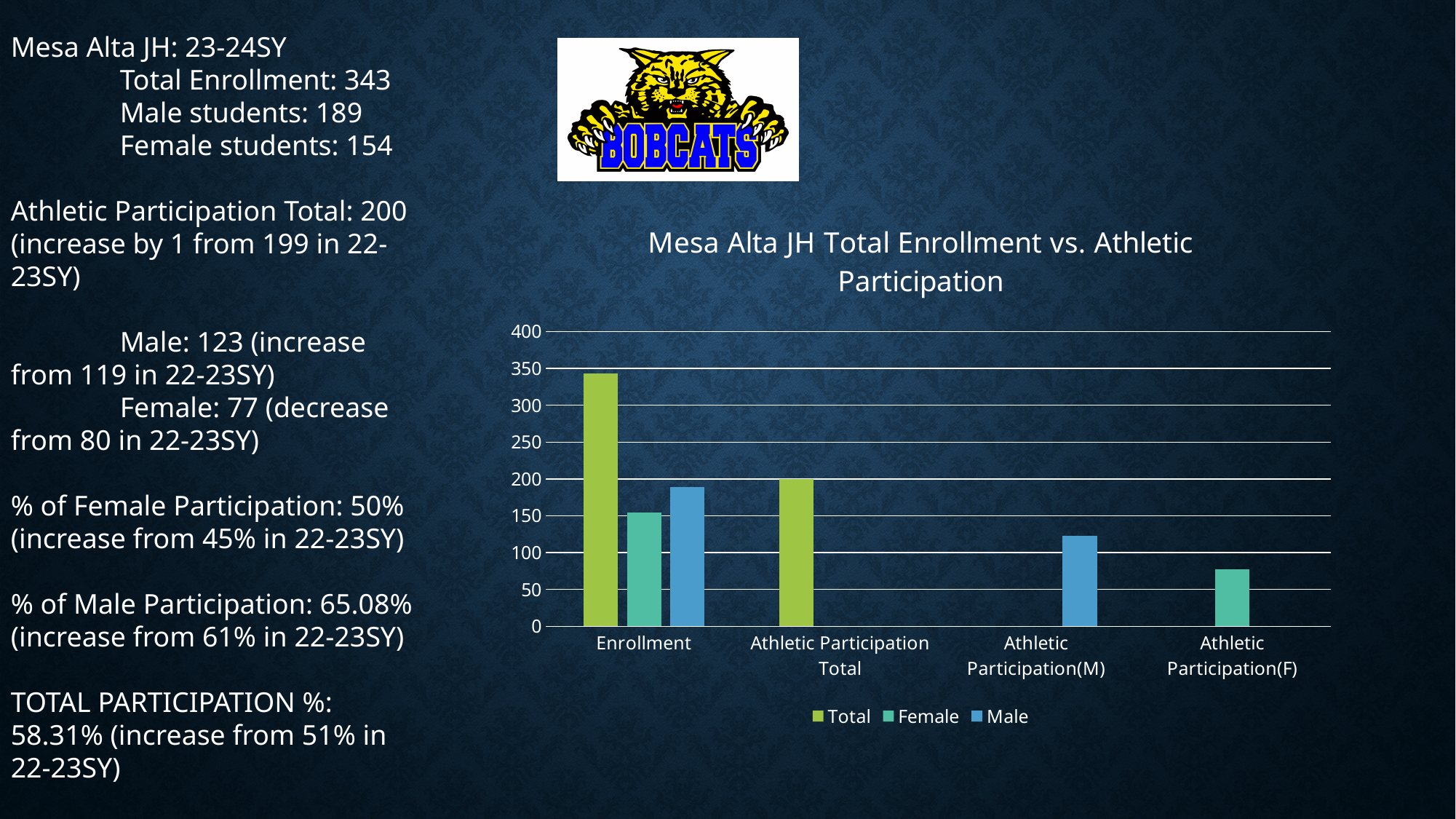
In the Enrollment category, which is larger, the Male bar or the Female bar? Male What kind of chart is shown on the slide? bar chart How many categories are shown on the x axis? 4 Which bar is the tallest in the chart? Total bar for Enrollment How many series does the legend list? 3 Is the Total value for Enrollment greater or less than 300? greater What is the title of the chart? Mesa Alta JH Total Enrollment vs. Athletic Participation What is the value of the Total bar for Athletic Participation Total? 200 Which bar is the shortest in the chart? Female bar for Athletic Participation(F) Is the Male value for Athletic Participation(M) greater or less than 100? greater Is the Female value for Athletic Participation(F) greater or less than 100? less